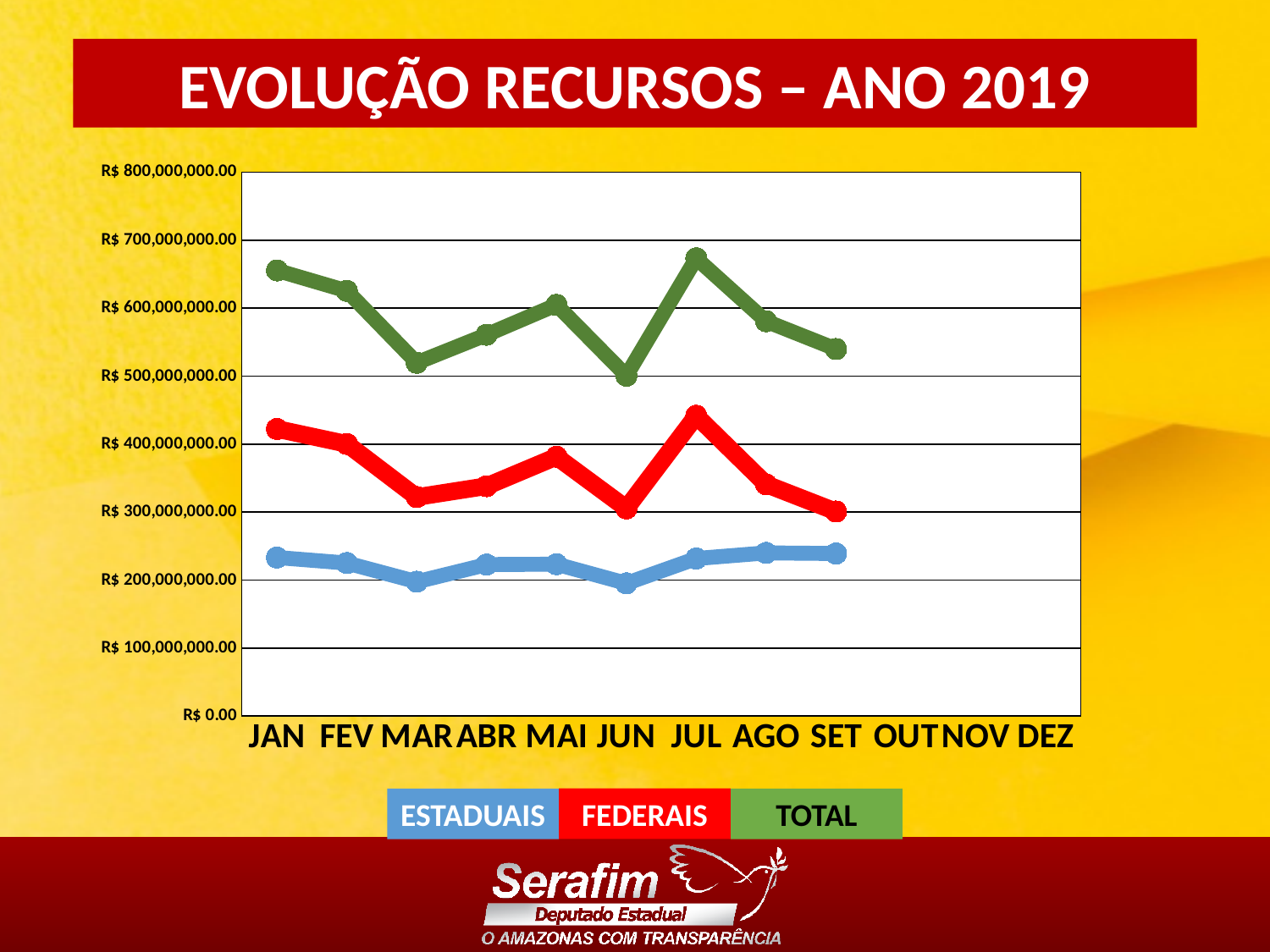
What kind of chart is shown on the slide? line chart Does the TOTAL series rise or fall from JAN to MAR? fall In JUL, which series has the larger value, FEDERAIS or ESTADUAIS? FEDERAIS In which month does the FEDERAIS series reach its highest value? JUL In which month does the TOTAL series reach its lowest value? JUN Is the ESTADUAIS value for JAN greater or less than R$ 200,000,000.00? greater Is the FEDERAIS value for JAN greater or less than R$ 400,000,000.00? greater How many month labels are shown on the x axis? 12 Is the TOTAL value for JAN greater or less than R$ 600,000,000.00? greater In which month does the TOTAL series reach its highest value? JUL What is the title of the chart? EVOLUÇÃO RECURSOS – ANO 2019 How many series does the legend list? 3